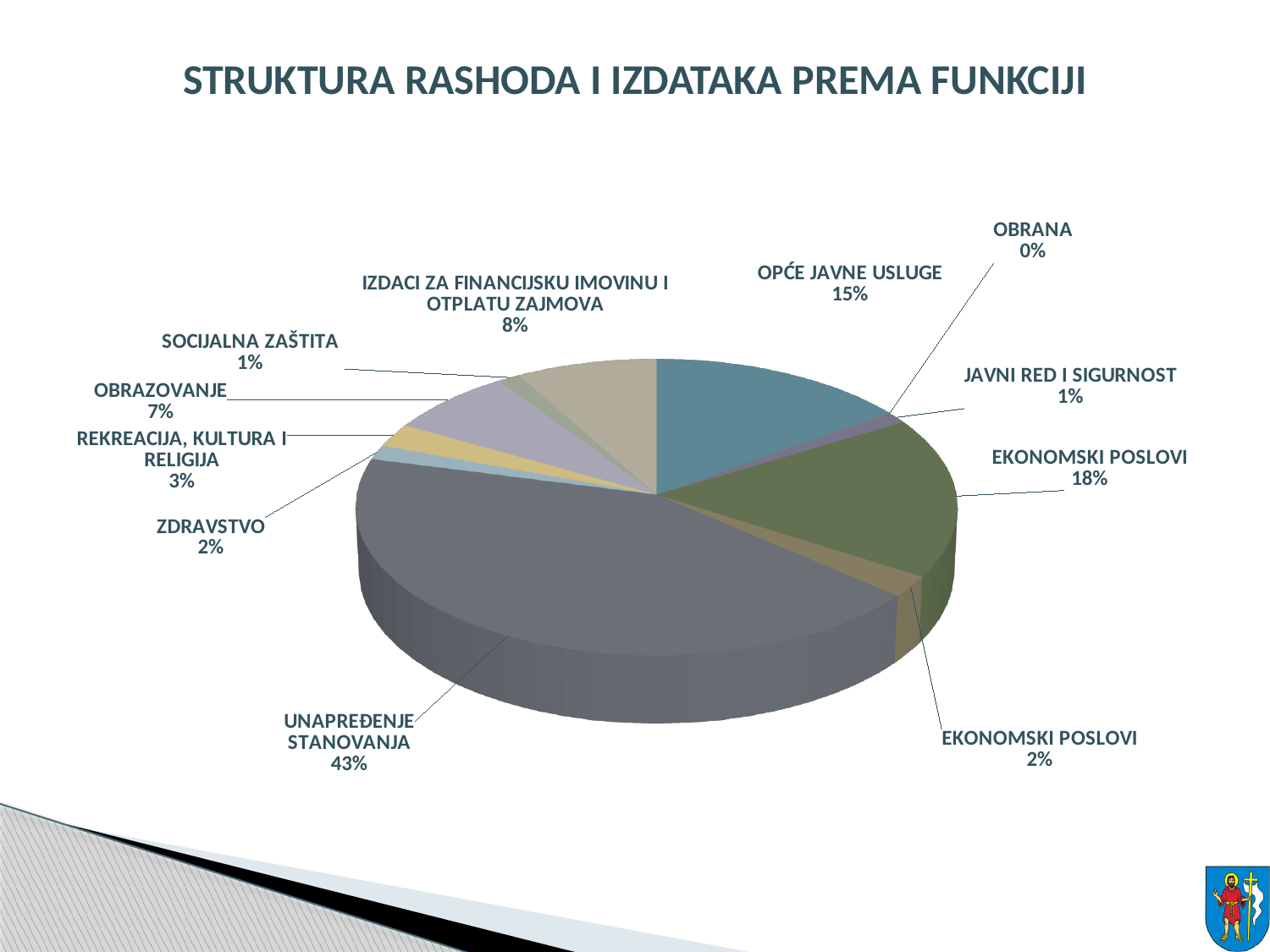
What is the value shown for REKREACIJA, KULTURA I RELIGIJA? 3% What is the value shown for IZDACI ZA FINANCIJSKU IMOVINU I OTPLATU ZAJMOVA? 8% Which category has the smallest share of the pie? OBRANA What kind of chart is shown on the slide? pie chart What share of the pie does UNAPREĐENJE STANOVANJA represent? 43% What is the value shown for OBRAZOVANJE? 7% What is the title of the chart? STRUKTURA RASHODA I IZDATAKA PREMA FUNKCIJI Which category has the largest share of the pie? UNAPREĐENJE STANOVANJA How many slices does the pie chart have? 11 Which is larger, the share for OBRAZOVANJE or the share for IZDACI ZA FINANCIJSKU IMOVINU I OTPLATU ZAJMOVA? IZDACI ZA FINANCIJSKU IMOVINU I OTPLATU ZAJMOVA What is the difference in percentage points between UNAPREĐENJE STANOVANJA and OPĆE JAVNE USLUGE? 28 What is the value shown for OPĆE JAVNE USLUGE? 15%